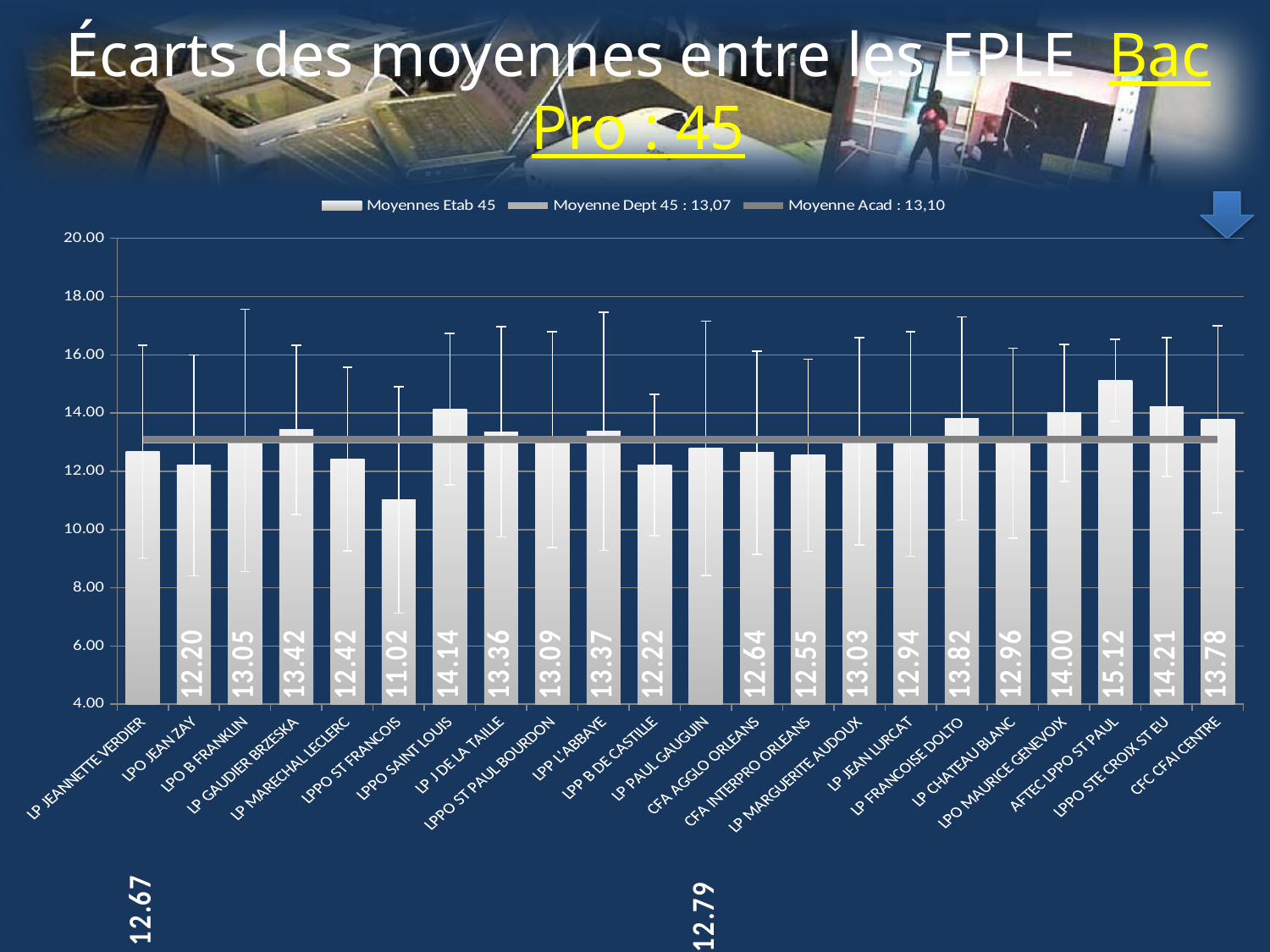
According to the legend, what is the value of Moyenne Dept 45? 13,07 What type of chart is shown on the slide? bar chart Is the value for LPPO STE CROIX ST EU greater or less than 14.00? greater What is the value for LPPO SAINT LOUIS? 14.14 Which establishment has the lowest value? LPPO ST FRANCOIS Which establishment has the highest value? AFTEC LPPO ST PAUL How many series does the legend list? 3 Which is larger, the value for LP GAUDIER BRZESKA or the value for LP MARECHAL LECLERC? LP GAUDIER BRZESKA What is the value for LP FRANCOISE DOLTO? 13.82 How many establishments are shown on the x axis? 22 What is the difference between the values for AFTEC LPPO ST PAUL and LPPO ST FRANCOIS? 4.10 What is the value for LPPO ST FRANCOIS? 11.02